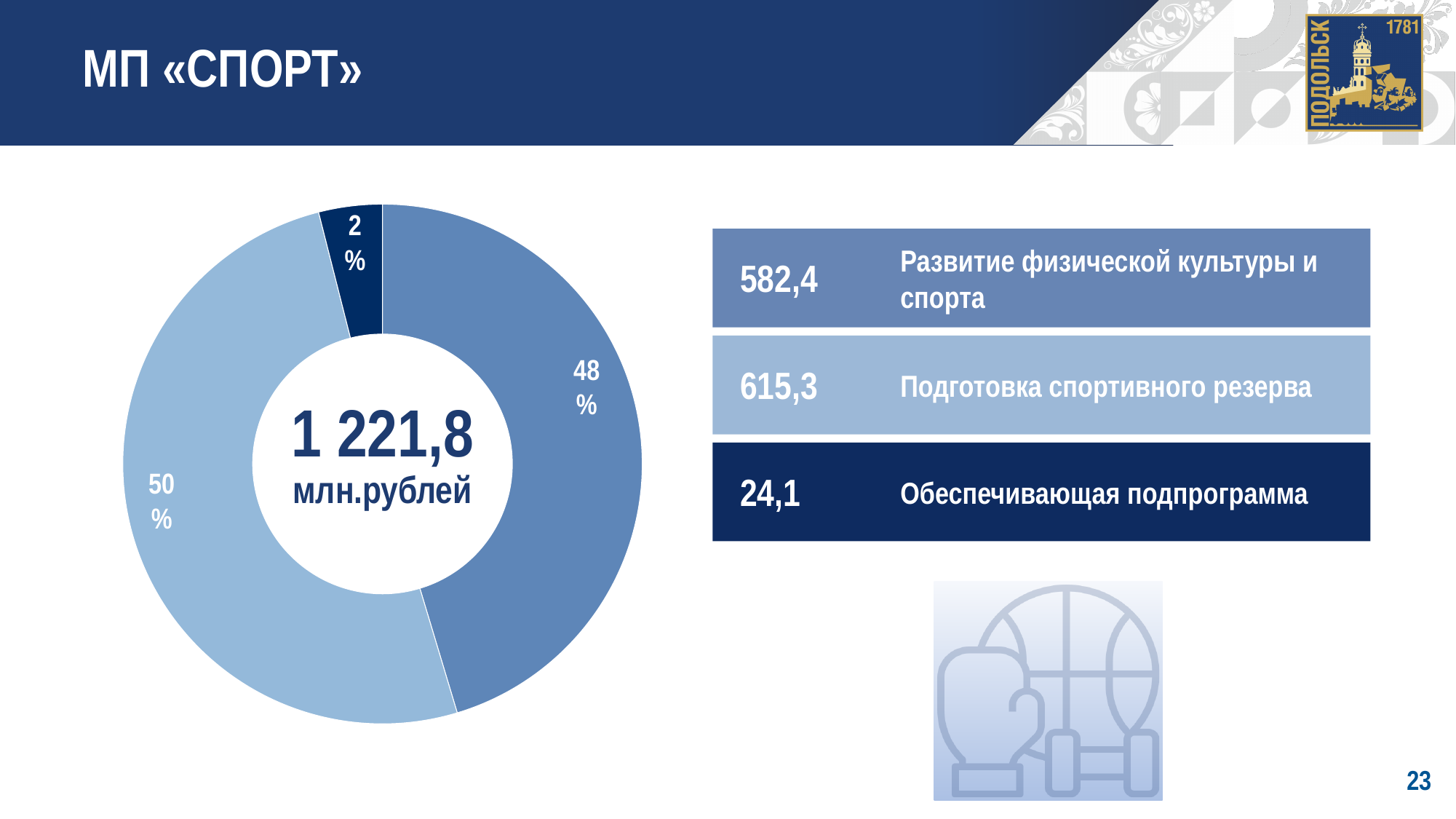
What share of the donut chart does «Развитие физической культуры и спорта» take? 48% How many slices does the donut chart have? 3 What share of the donut chart does «Обеспечивающая подпрограмма» take? 2% What is the value shown for «Подготовка спортивного резерва»? 615,3 Which subprogram has the smallest share of the donut chart? Обеспечивающая подпрограмма What share of the donut chart does «Подготовка спортивного резерва» take? 50% What total amount is shown in the centre of the donut chart? 1 221,8 млн.рублей What kind of chart is shown on the slide? Pie (donut) chart What is the value shown for «Развитие физической культуры и спорта»? 582,4 Which subprogram has the largest share of the donut chart? Подготовка спортивного резерва What is the value shown for «Обеспечивающая подпрограмма»? 24,1 What is the difference between the values for «Подготовка спортивного резерва» and «Развитие физической культуры и спорта»? 32,9